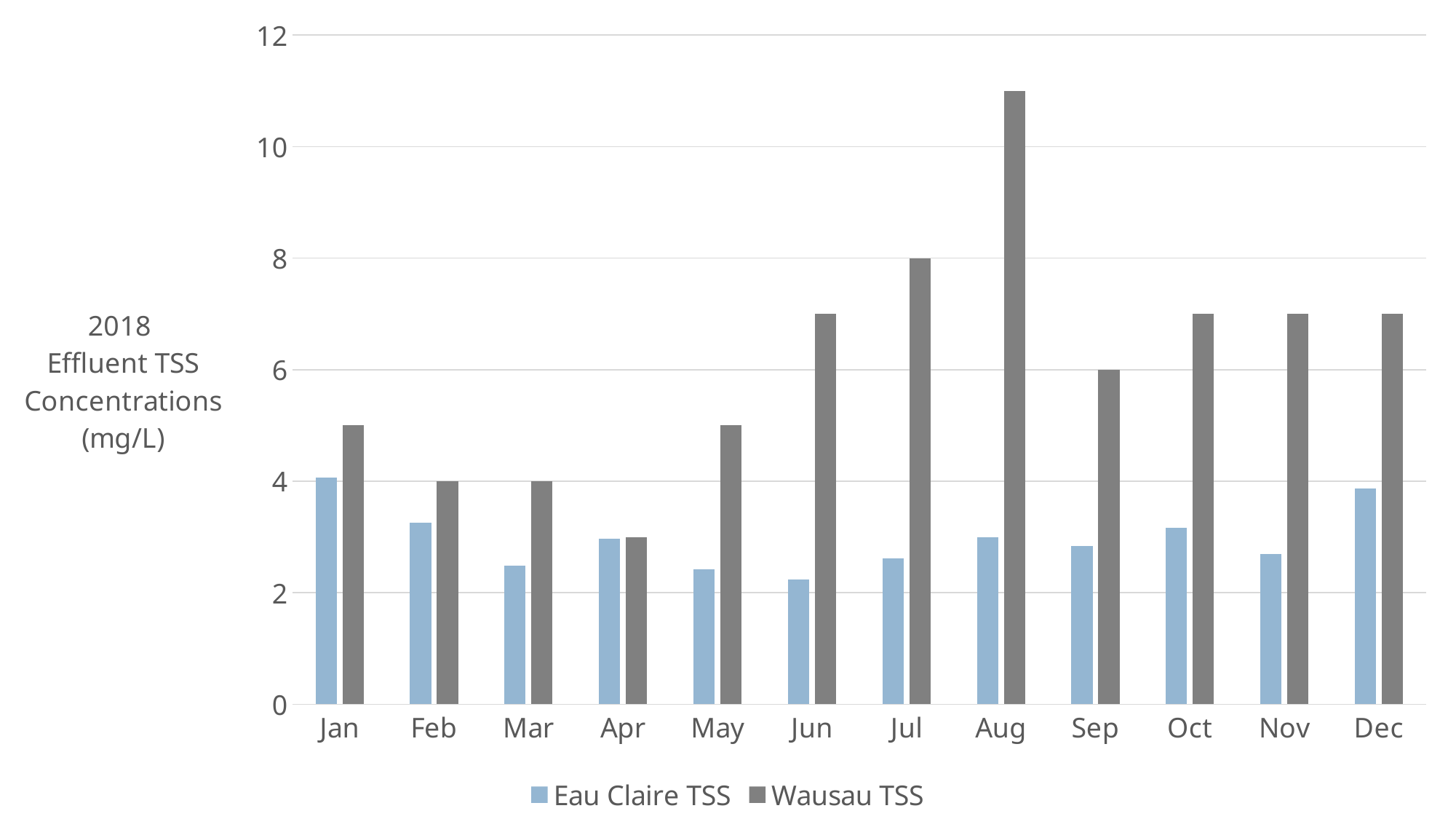
What is the Wausau TSS value for Sep? 6 Which month has the lowest Wausau TSS value? Apr Is the Eau Claire TSS value for Jun greater or less than 4? less In Aug, which is larger: Eau Claire TSS or Wausau TSS? Wausau TSS How many series does the legend list? 2 What is the Wausau TSS value for Jul? 8 Which month has the highest Wausau TSS value? Aug Does the Wausau TSS value rise or fall from May to Aug? rise How many months are shown on the x axis? 12 What type of chart is shown on the slide? bar chart What is the difference between the Wausau TSS values for Jul and Feb? 4 Is the Wausau TSS value for Aug greater or less than 10? greater